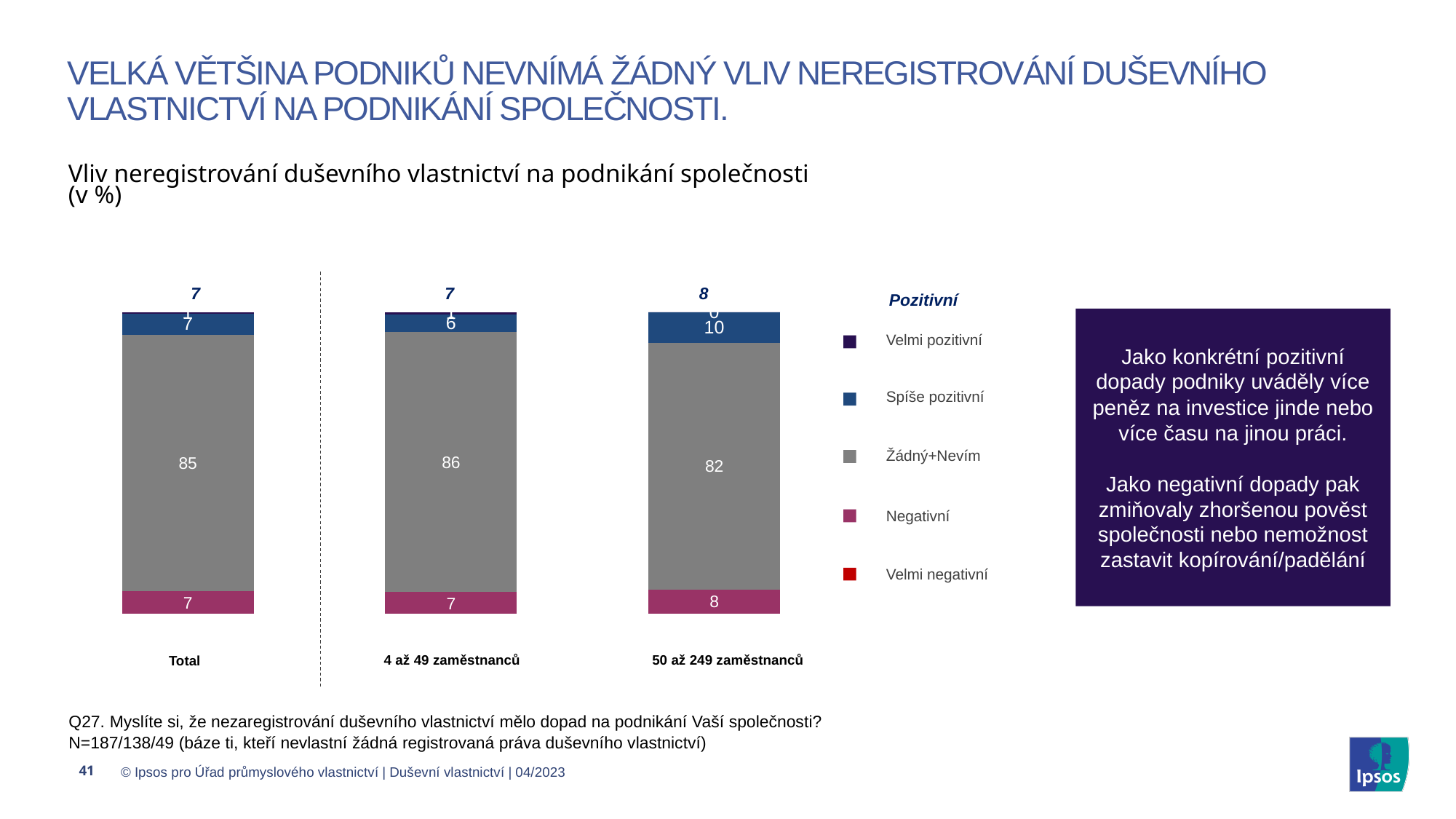
What is the Pozitivní total shown above the bar for 50 až 249 zaměstnanců? 8 Is the Spíše pozitivní value larger for 4 až 49 zaměstnanců or for 50 až 249 zaměstnanců? 50 až 249 zaměstnanců What is the value of Žádný+Nevím for the Total bar? 85 What is the value of Žádný+Nevím for 4 až 49 zaměstnanců? 86 Which category has the lowest Žádný+Nevím value? 50 až 249 zaměstnanců What is the Spíše pozitivní value for 50 až 249 zaměstnanců? 10 What is the difference between the Žádný+Nevím values for 4 až 49 zaměstnanců and 50 až 249 zaměstnanců? 4 How many series does the legend list? 5 Which category has the highest Žádný+Nevím value? 4 až 49 zaměstnanců What is the Negativní value for 50 až 249 zaměstnanců? 8 What kind of chart is shown on the slide? Stacked bar chart What is the value of Žádný+Nevím for 50 až 249 zaměstnanců? 82